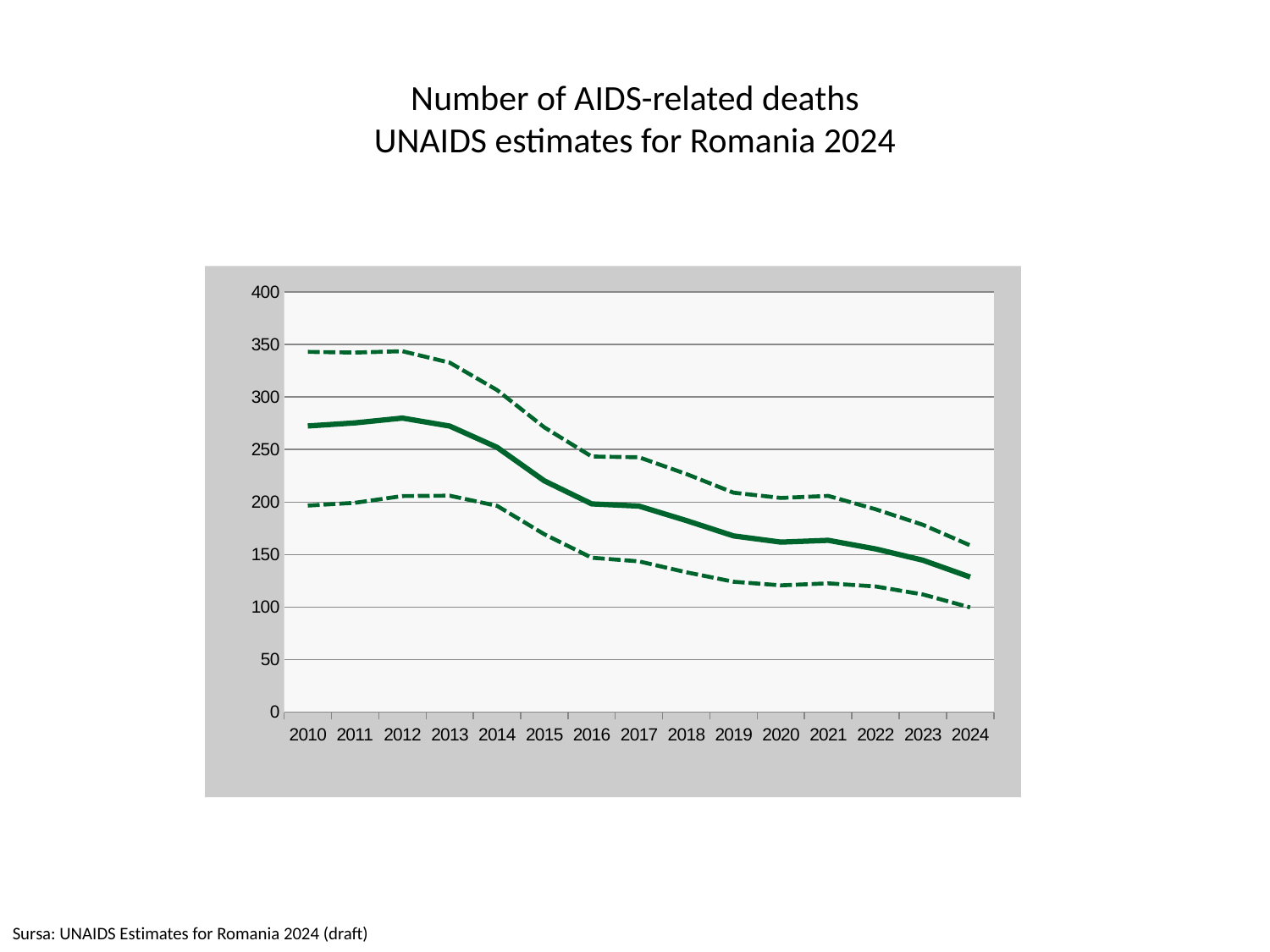
Does the solid line rise or fall overall from 2010 to 2024? fall Which year has the larger value on the solid line, 2015 or 2021? 2015 What kind of chart is shown on the slide? line chart Is the value of the solid line for 2019 greater or less than 200? less Is the value of the upper dashed line for 2024 greater or less than 150? greater Is the value of the solid line for 2024 greater or less than 150? less What is the first year shown on the x axis? 2010 How many years are shown on the x axis of the chart? 15 What is the title of the chart on the slide? Number of AIDS-related deaths UNAIDS estimates for Romania 2024 In which year does the solid line reach its highest value? 2012 In which year does the solid line reach its lowest value? 2024